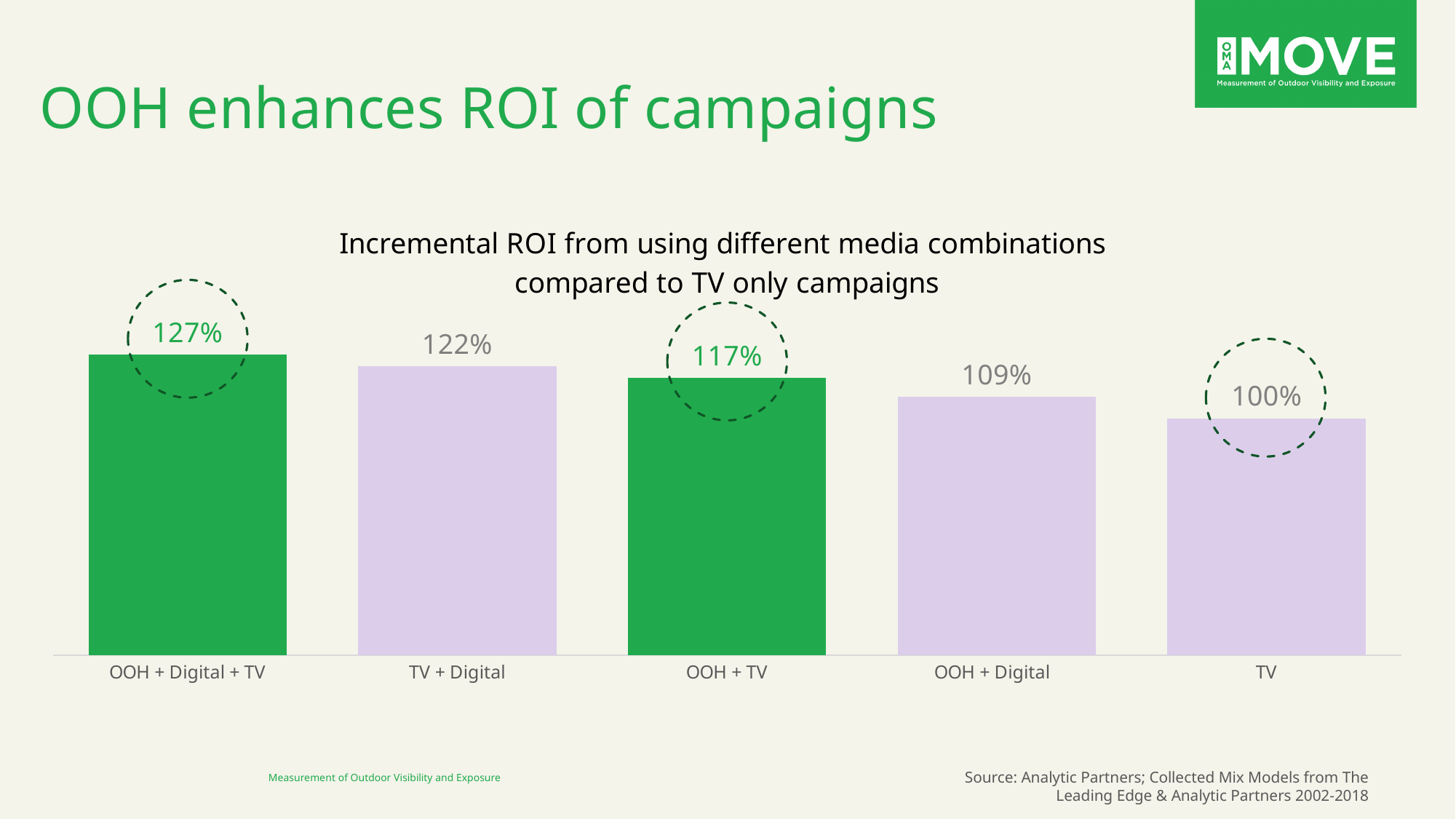
What is the value for OOH + Digital + TV? 127% What is the title of the chart? Incremental ROI from using different media combinations compared to TV only campaigns What is the value for TV + Digital? 122% Which category has the lowest value? TV What is the value for OOH + Digital? 109% What is the difference between the values for OOH + Digital + TV and TV? 27% What kind of chart is shown on the slide? Bar chart Which is larger, the value for TV + Digital or the value for OOH + TV? TV + Digital Which media combination has the highest incremental ROI? OOH + Digital + TV What is the value for TV? 100% How many media combinations are shown in the chart? 5 What is the value for OOH + TV? 117%